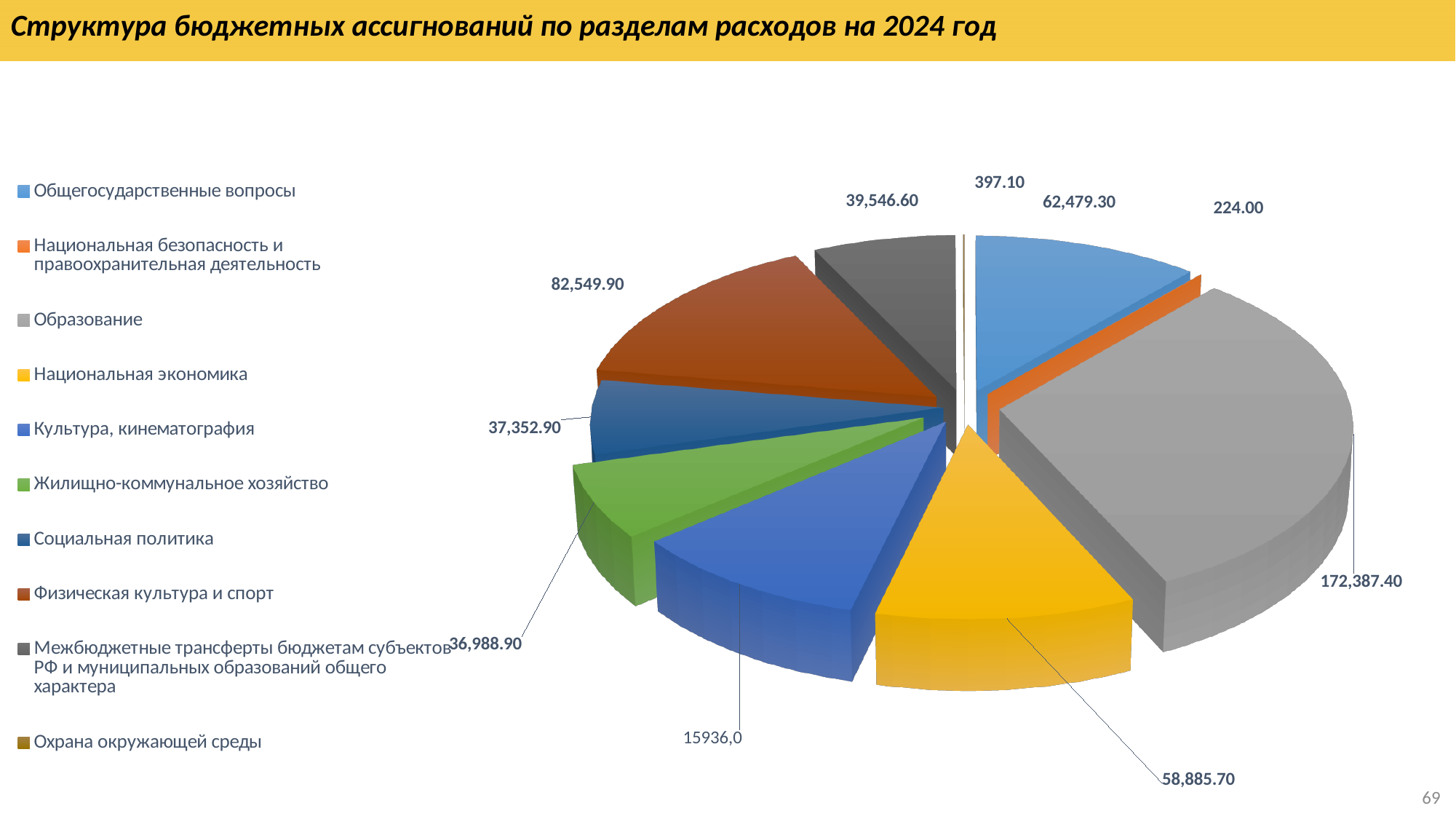
Which category has the smallest value? Национальная безопасность и правоохранительная деятельность What kind of chart is shown on the slide? Pie chart Which category has the largest value? Образование What is the value for Национальная безопасность и правоохранительная деятельность? 224.00 What is the value for Физическая культура и спорт? 82,549.90 What is the value for Охрана окружающей среды? 397.10 What is the value for Общегосударственные вопросы? 62,479.30 What is the value for Образование? 172,387.40 How many categories does the legend list? 10 What is the difference between the values for Образование and Общегосударственные вопросы? 109,908.10 What is the title of the chart? Структура бюджетных ассигнований по разделам расходов на 2024 год Which is larger: Социальная политика or Жилищно-коммунальное хозяйство? Социальная политика